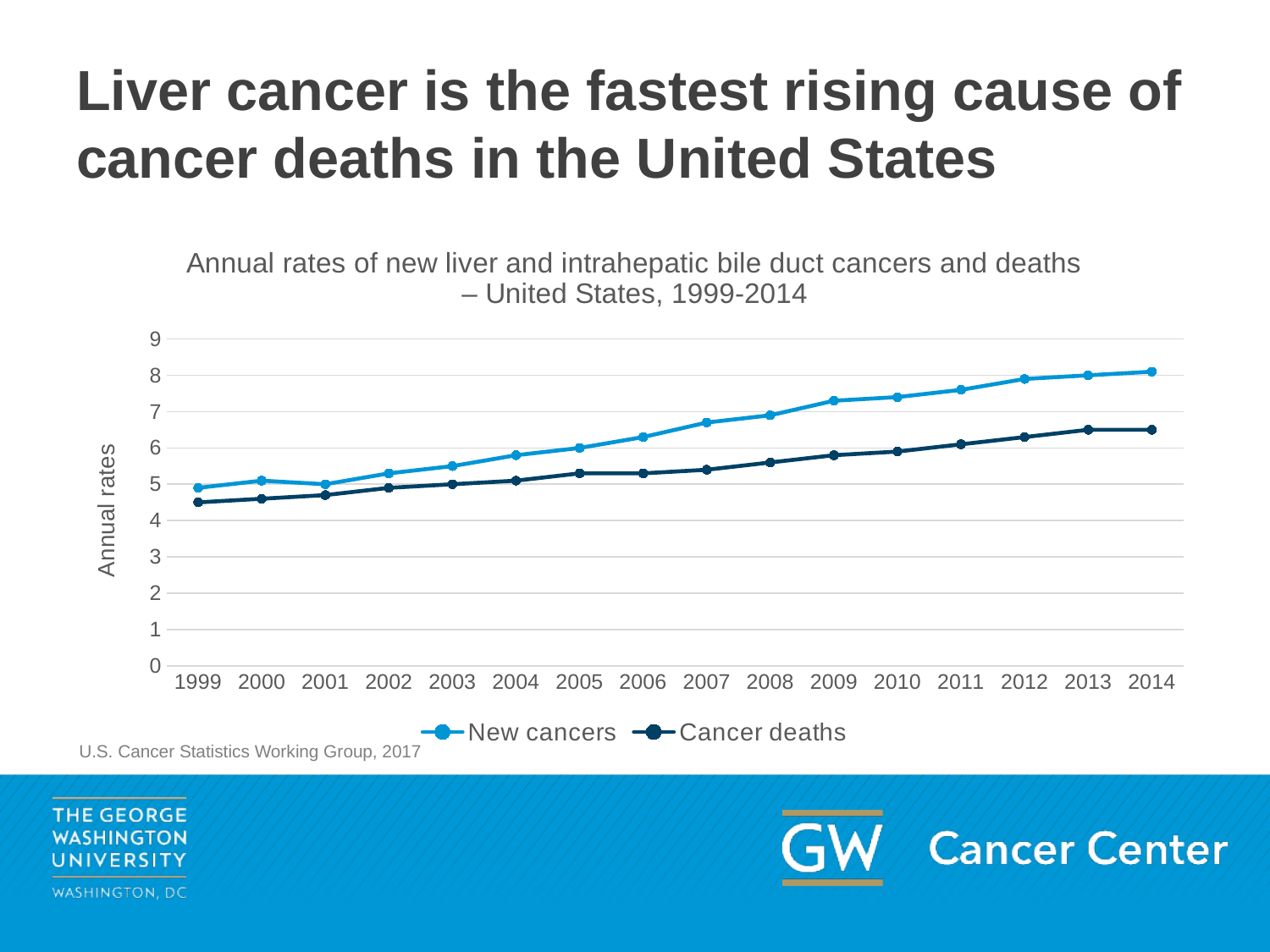
In 2014, which series has the larger value, New cancers or Cancer deaths? New cancers How many years are plotted along the x axis? 16 Is the value for Cancer deaths in 2014 greater or less than 7? less Is the value for Cancer deaths in 2008 greater or less than 6? less Is the value for New cancers in 2009 greater or less than 7? greater What kind of chart is shown on the slide? line chart What is the label on the y axis? Annual rates How many series does the legend list? 2 Do the New cancers values rise or fall from 1999 to 2014? rise What is the title of the chart? Annual rates of new liver and intrahepatic bile duct cancers and deaths – United States, 1999-2014